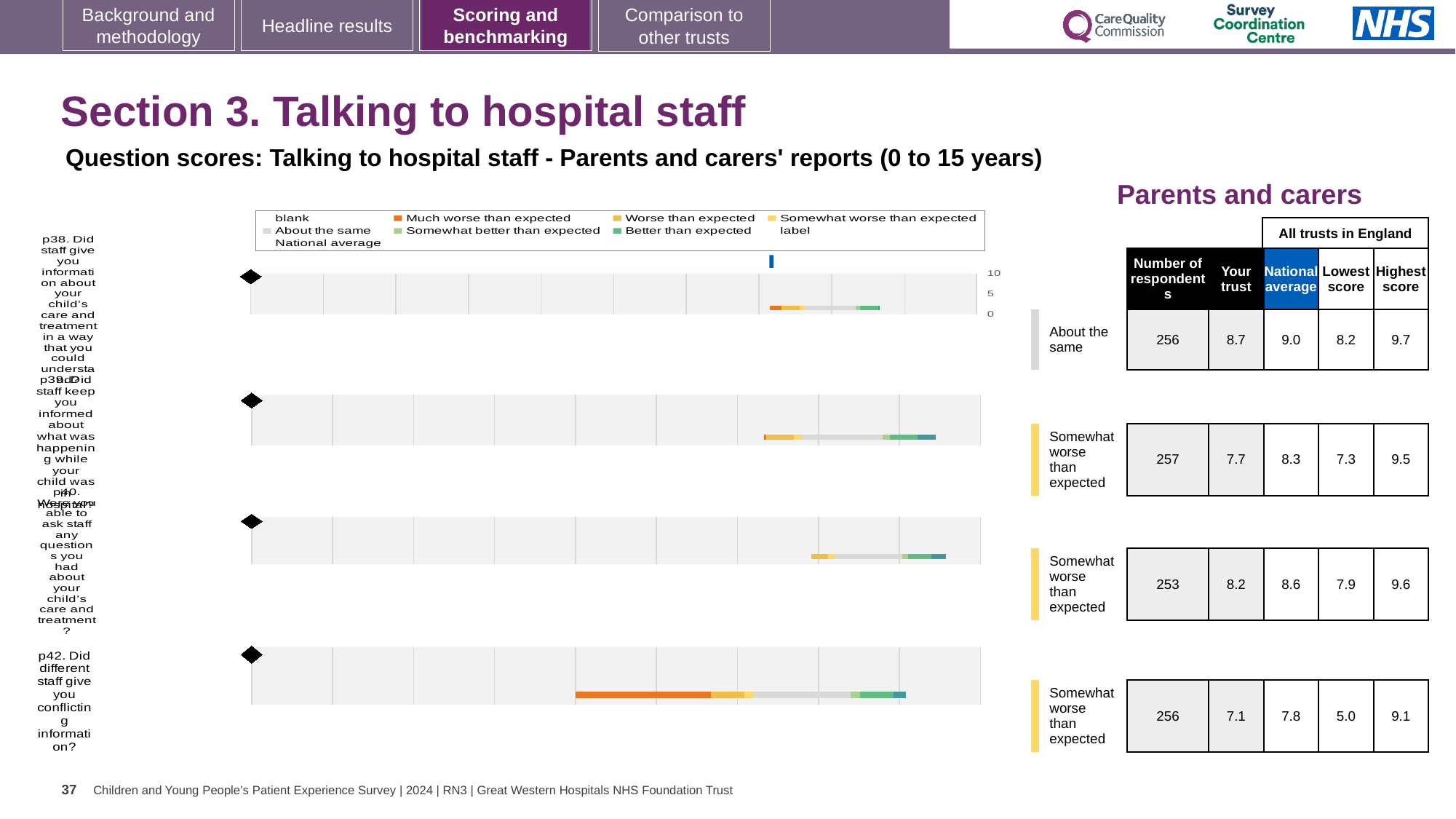
What kind of chart is used to show the question scores on this slide? bar chart For the p42 chart, what is the difference between the National average and the 'Your trust' score? 0.7 For the p38 chart (staff giving information about your child's care), what is the 'Your trust' score shown in the table? 8.7 Across the four charts, which question has the lowest 'Your trust' score? p42 For the p39 chart (staff keeping you informed), what is the Lowest score across all trusts in England? 7.3 What benchmark category label is shown next to the p38 chart? About the same For the p38 chart, which is larger: the 'Your trust' score or the National average? National average Across the four charts, which question has the highest 'Your trust' score? p38 For the p40 chart (able to ask staff questions), what is the Highest score across all trusts in England? 9.6 How many questions (p38, p39, p40, p42) have a score chart on this slide? 4 For the p38 chart, what is the National average score? 9.0 For the p42 chart (different staff giving conflicting information), how many respondents are listed? 256